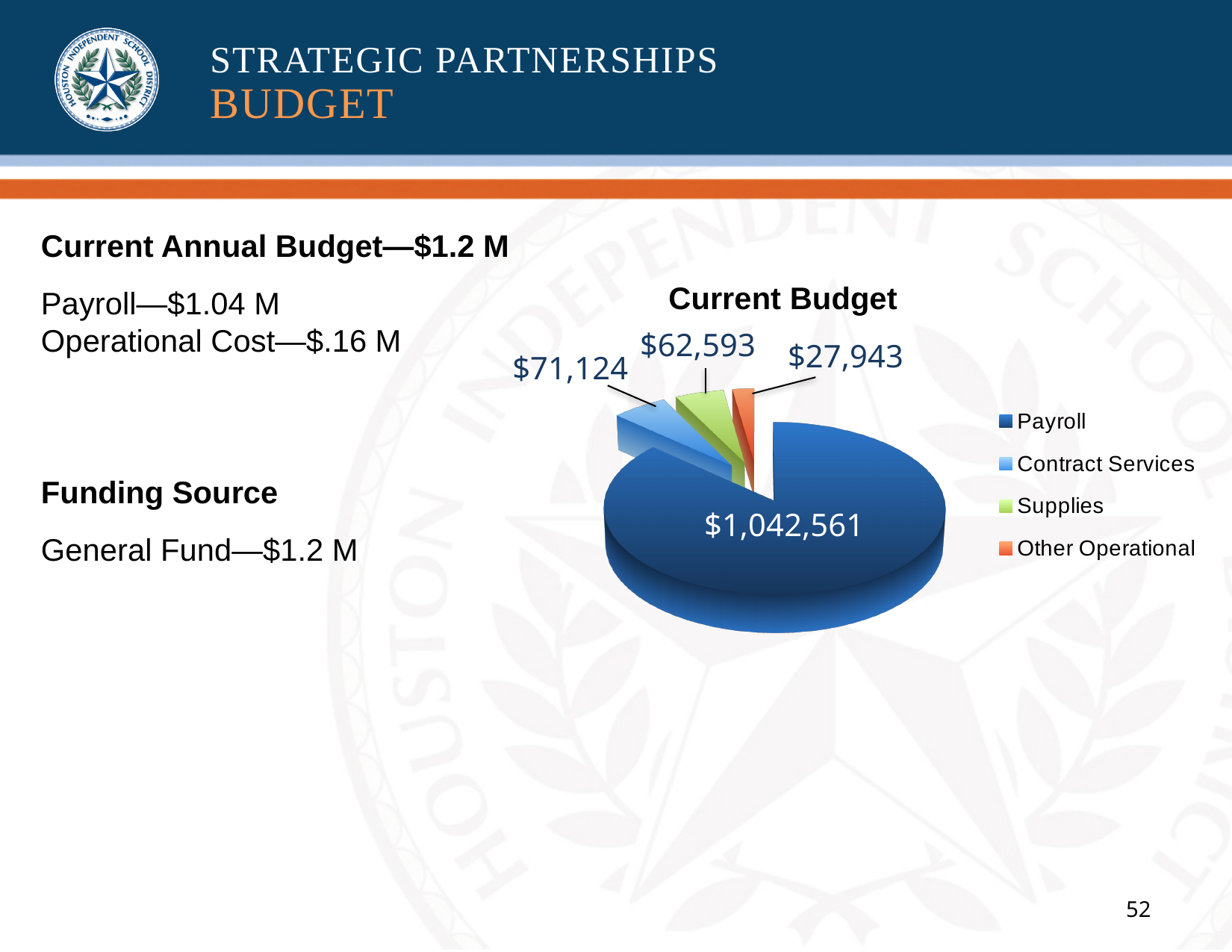
What is the difference between the Contract Services and Supplies values in the Current Budget chart? $8,531 What is the value of the Other Operational slice in the Current Budget chart? $27,943 How many categories does the legend of the Current Budget chart list? 4 Which category has the largest slice in the Current Budget chart? Payroll What is the title of the chart? Current Budget What type of chart is shown on the slide? pie chart What is the value of the Contract Services slice in the Current Budget chart? $71,124 What colour is the Payroll slice in the Current Budget chart? dark blue Which category has the smallest slice in the Current Budget chart? Other Operational What is the value of the Payroll slice in the Current Budget chart? $1,042,561 Which is larger in the Current Budget chart, Contract Services or Supplies? Contract Services What is the value of the Supplies slice in the Current Budget chart? $62,593